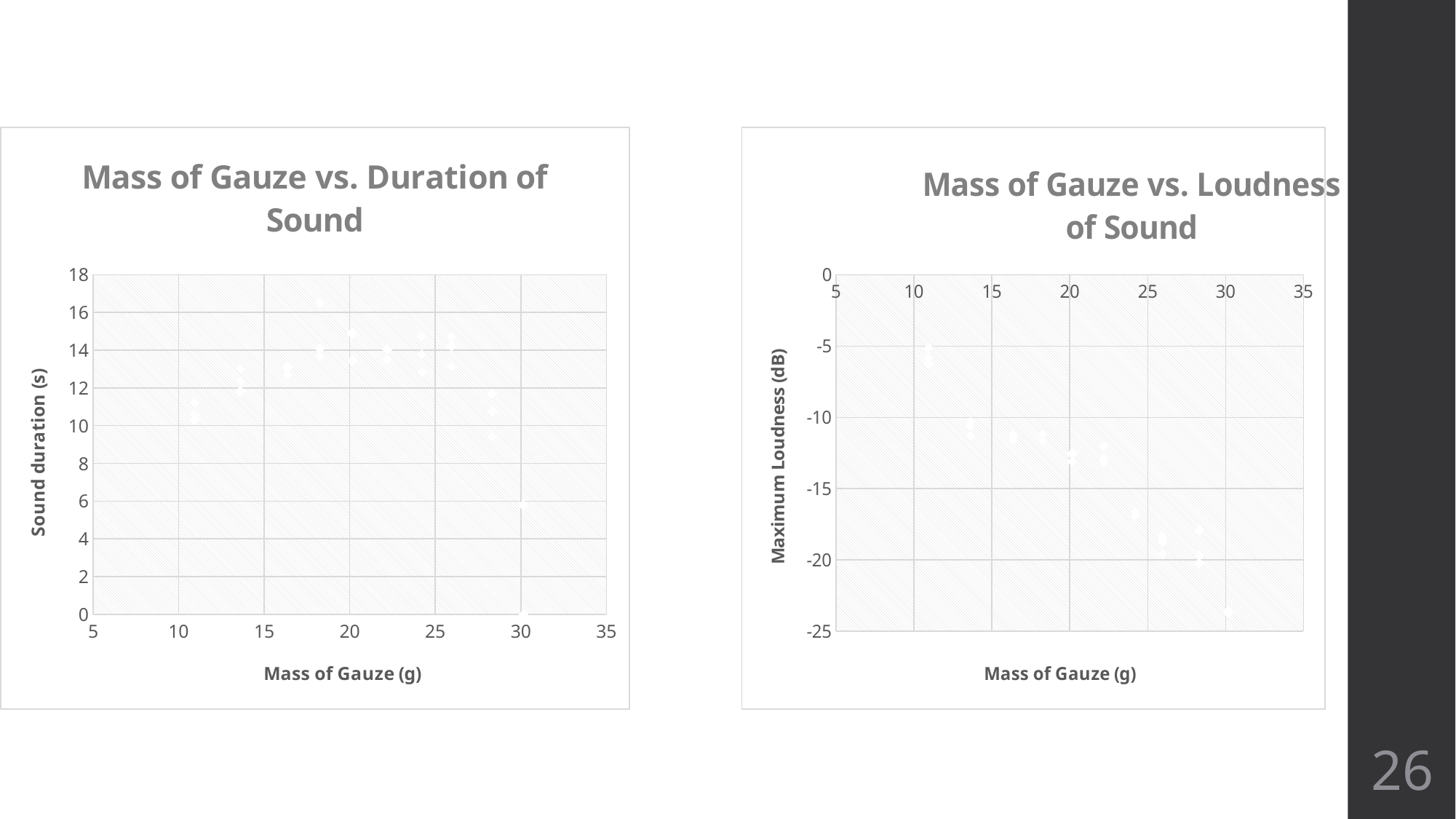
In the right chart, "Mass of Gauze vs. Loudness of Sound", what is the lowest value shown on the y-axis? -25 What kind of chart is the left chart, titled "Mass of Gauze vs. Duration of Sound"? scatter chart In the right chart, "Mass of Gauze vs. Loudness of Sound", do the maximum loudness values rise or fall as the mass of gauze increases? fall How many charts are shown on the slide? 2 What kind of chart is the right chart, titled "Mass of Gauze vs. Loudness of Sound"? scatter chart What is the y-axis label of the right chart, "Mass of Gauze vs. Loudness of Sound"? Maximum Loudness (dB) In the left chart, "Mass of Gauze vs. Duration of Sound", what is the highest value shown on the y-axis? 18 What is the y-axis label of the left chart, "Mass of Gauze vs. Duration of Sound"? Sound duration (s)